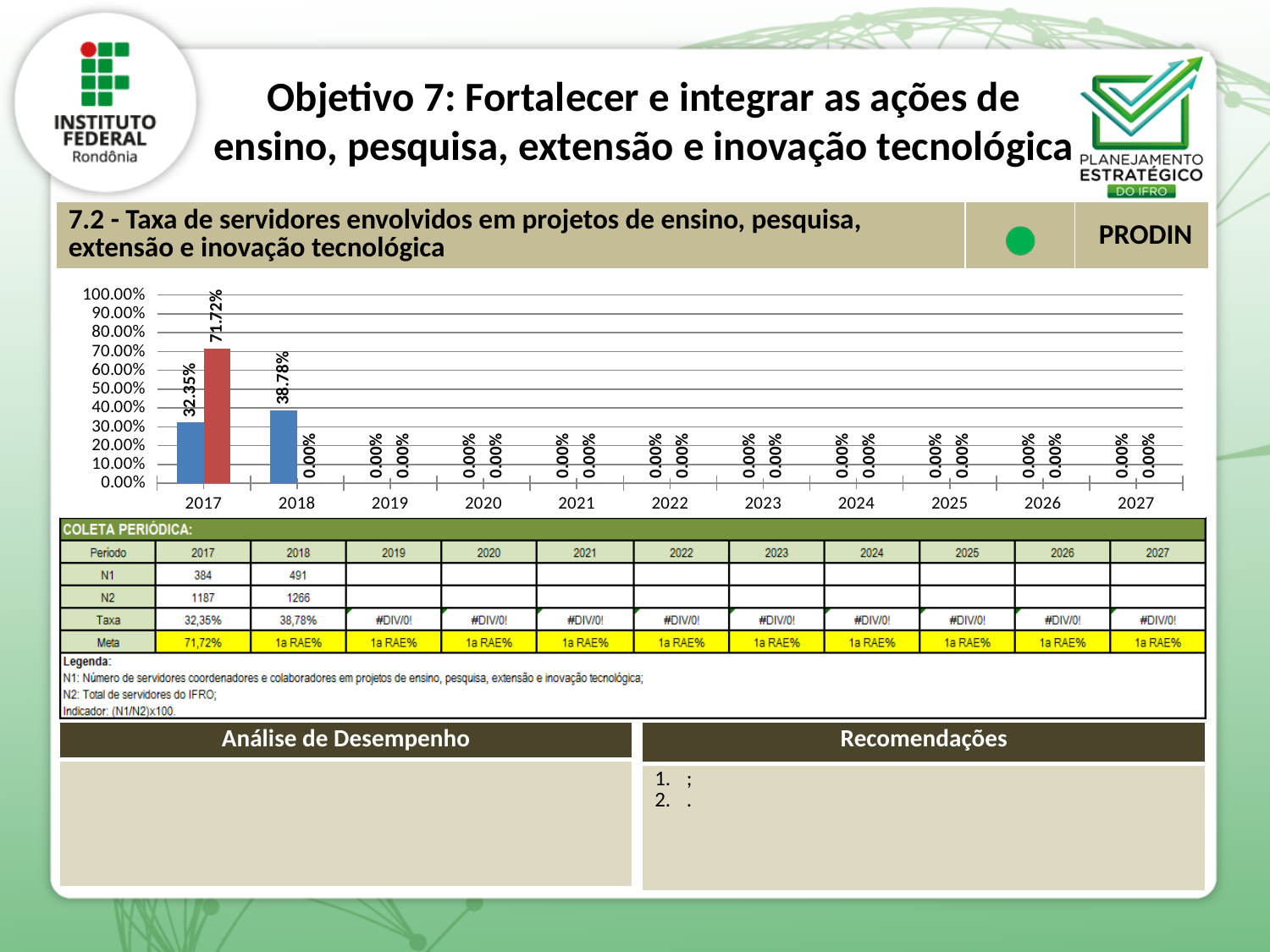
Is the red bar for 2017 greater or less than 70.00%? greater How many years are shown on the x axis of the chart? 11 What is the difference between the blue bar values for 2018 and 2017? 6.43% What kind of chart is shown on the slide? bar chart What value is labelled for the bars in 2019? 0.00% Which is larger, the blue bar for 2017 or the blue bar for 2018? 2018 What is the highest value shown on the y axis of the chart? 100.00% What value is shown on the blue bar for 2018? 38.78% Which year has the highest labelled value in the chart? 2017 What value is shown on the blue bar for 2017? 32.35% What value is shown on the red bar for 2017? 71.72% What is the difference between the red bar and the blue bar in 2017? 39.37%